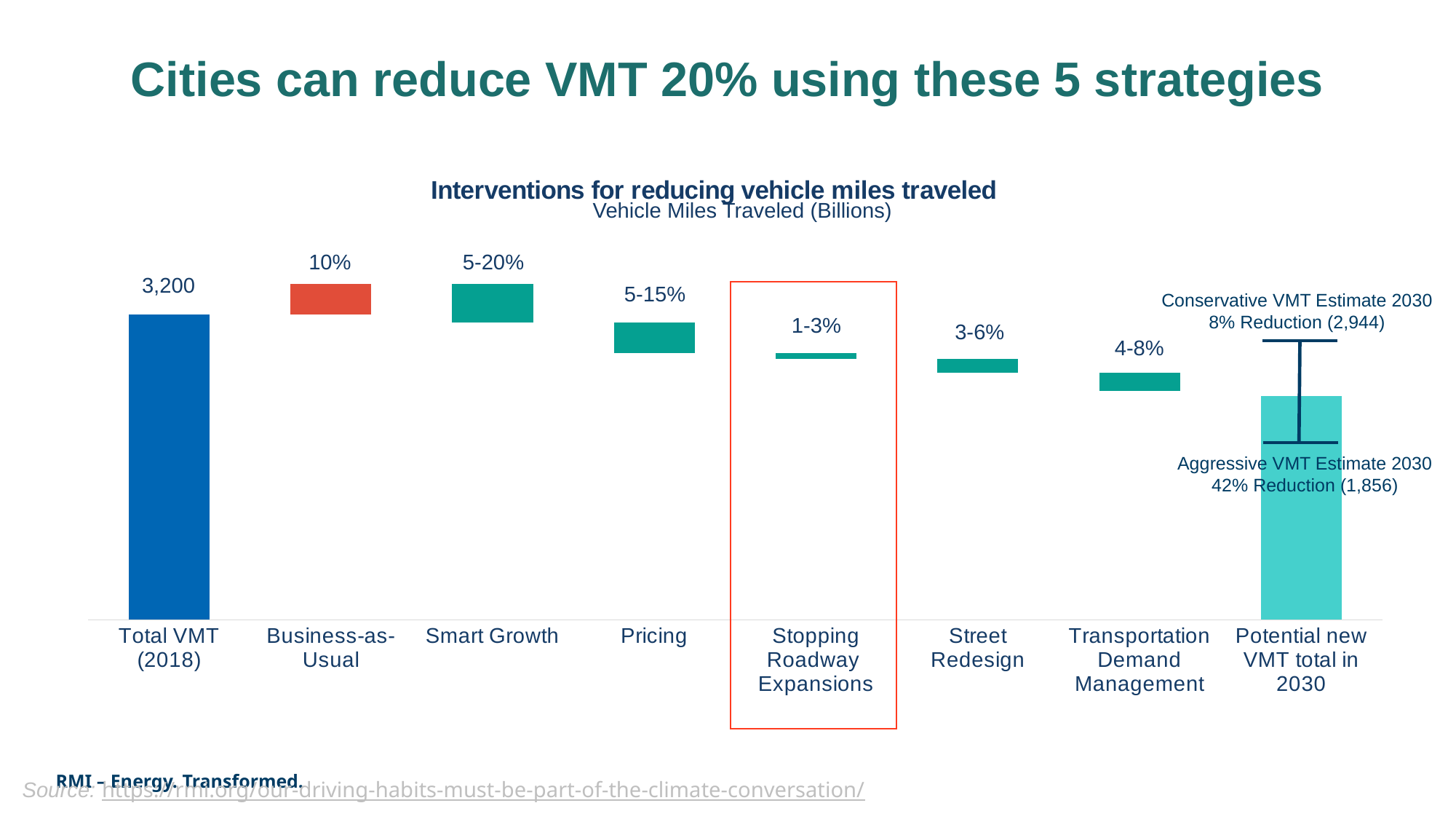
What is the Conservative VMT Estimate for 2030 shown on the chart? 2,944 What is the Aggressive VMT Estimate for 2030 shown on the chart? 1,856 What percentage is labeled for Business-as-Usual? 10% Which category on the chart is outlined with a red box? Stopping Roadway Expansions What is the difference between the Conservative VMT Estimate 2030 (2,944) and the Aggressive VMT Estimate 2030 (1,856)? 1,088 What is the value labeled for Total VMT (2018)? 3,200 What reduction range is labeled for Pricing? 5-15% What reduction range is labeled for Street Redesign? 3-6% What reduction range is labeled for Stopping Roadway Expansions? 1-3% What reduction range is labeled for Smart Growth? 5-20% What reduction range is labeled for Transportation Demand Management? 4-8% How many categories are shown along the x axis of the chart? 8